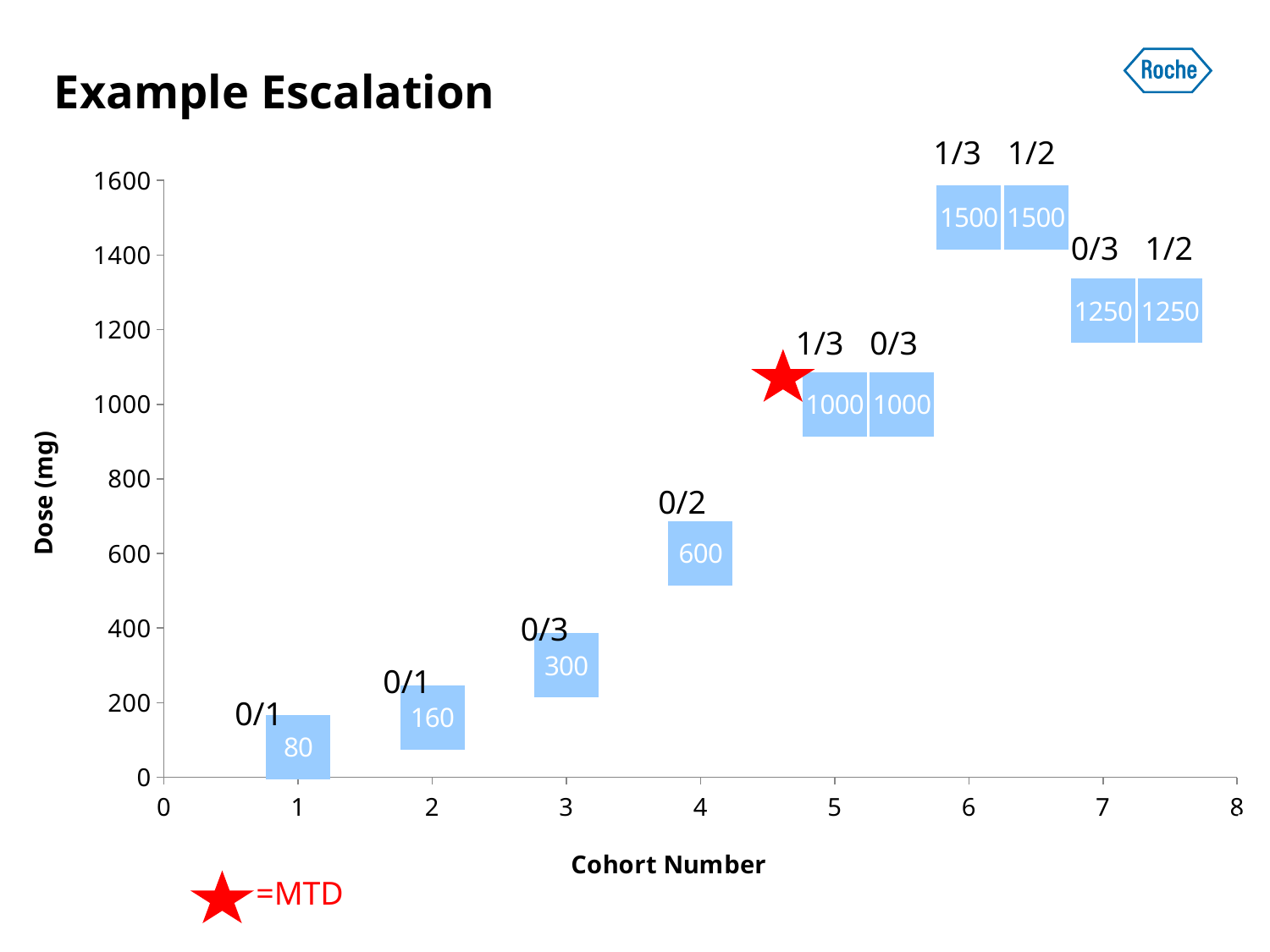
What is the difference in dose between cohort 4 and cohort 3? 300 What dose (mg) is shown for cohort 1? 80 Does the dose rise or fall from cohort 1 to cohort 6? Rise Which has the higher dose, cohort 6 or cohort 7? Cohort 6 What does the red star on the chart indicate? MTD Which cohort number has the lowest dose? 1 What dose (mg) is shown for cohort 4? 600 What dose (mg) is shown for cohort 3? 300 How many dose markers are plotted on the chart? 10 Is the dose for cohort 2 greater or less than 200? less What kind of chart is this? Scatter chart What is the highest dose value labelled on the chart? 1500